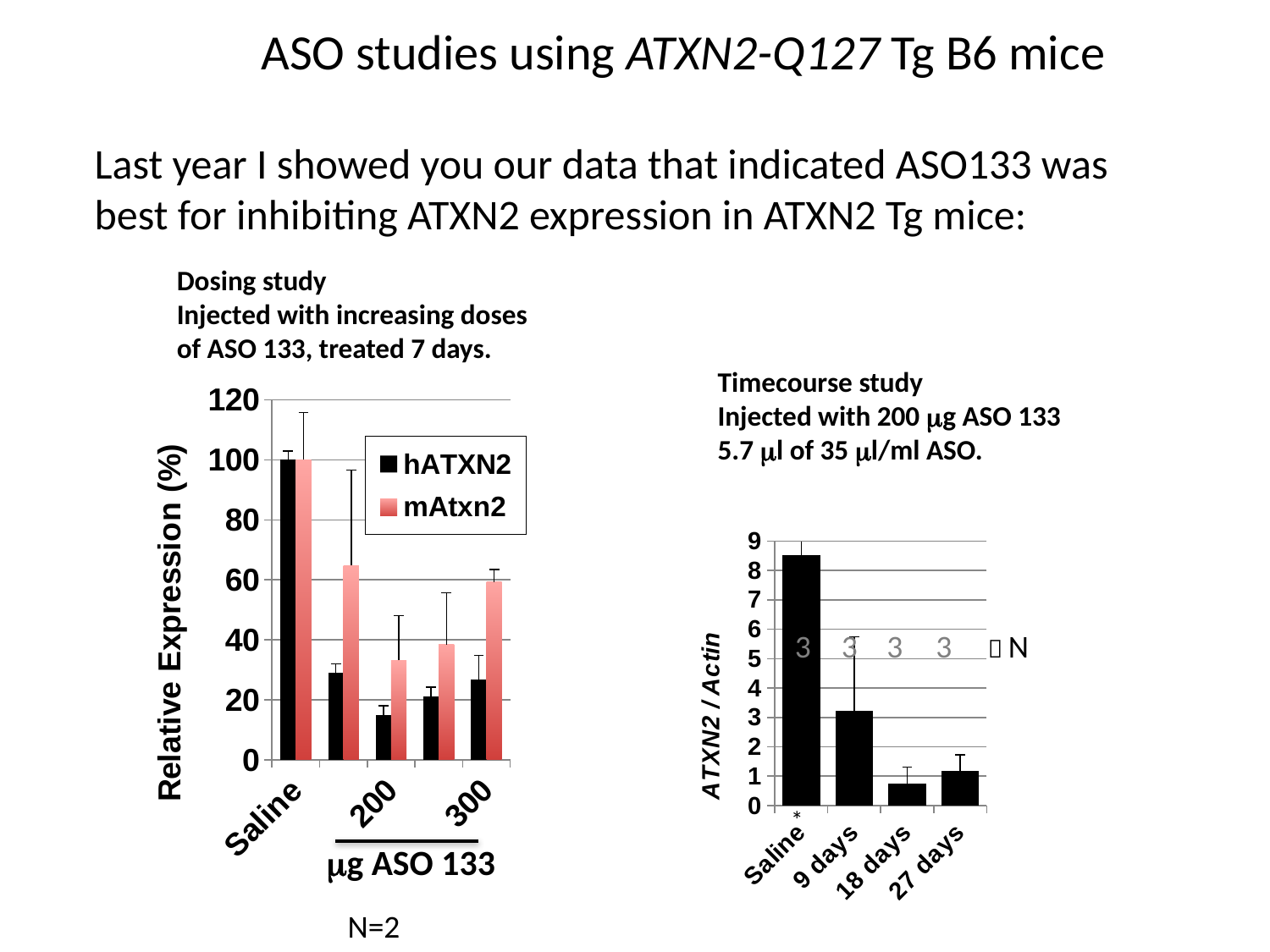
How many categories are shown on the x axis of the Timecourse study chart? 4 How many series does the legend of the Dosing study chart list? 2 In the Timecourse study chart, is the value for 9 days greater or less than 4? less In the Dosing study chart, is the hATXN2 value at 200 µg ASO 133 greater or less than 20? less In the Timecourse study chart, which category has the lowest ATXN2 / Actin value? 18 days What kind of chart is the Timecourse study chart on the right? bar chart In the Timecourse study chart, which category has the highest ATXN2 / Actin value? Saline In the Dosing study chart, what is the hATXN2 value for Saline? 100 In the Dosing study chart, is the mAtxn2 value at 300 µg ASO 133 greater or less than 40? greater In the Dosing study chart, what are the two series named in the legend? hATXN2 and mAtxn2 What kind of chart is the Dosing study chart on the left? bar chart In the Dosing study chart, at 200 µg ASO 133, which series has the larger value, hATXN2 or mAtxn2? mAtxn2